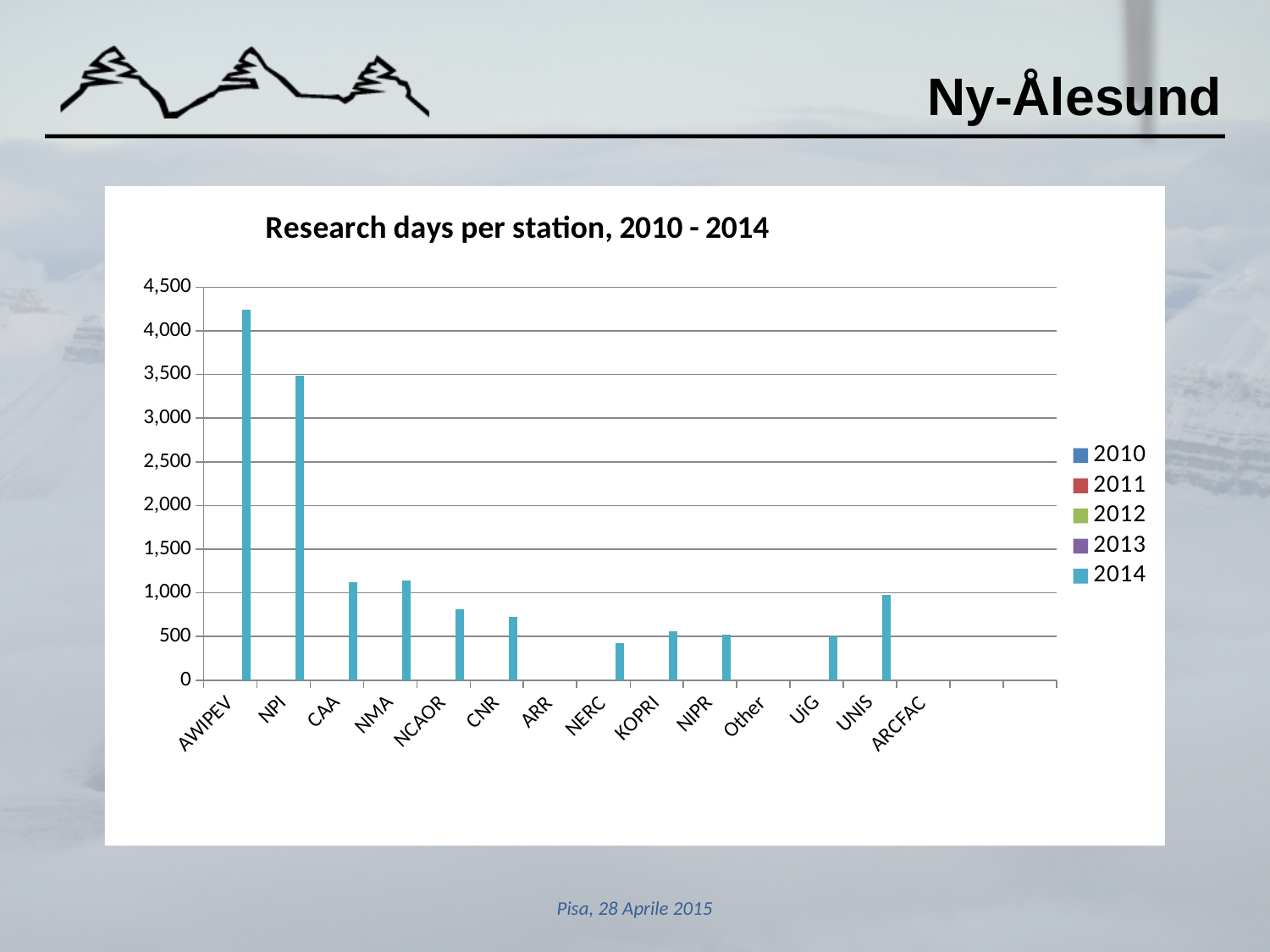
What is the title of the chart? Research days per station, 2010 - 2014 Is the value for CNR greater or less than 1,000? less Is the value for NPI greater or less than 3,000? greater Which station has the highest number of research days? AWIPEV Which has more research days, AWIPEV or NPI? AWIPEV Is the value for CAA greater or less than 1,000? greater How many series does the legend list? 5 Which year's series is shown in light blue in the legend? 2014 What type of chart is shown on the slide? bar chart Which has more research days, NPI or CAA? NPI